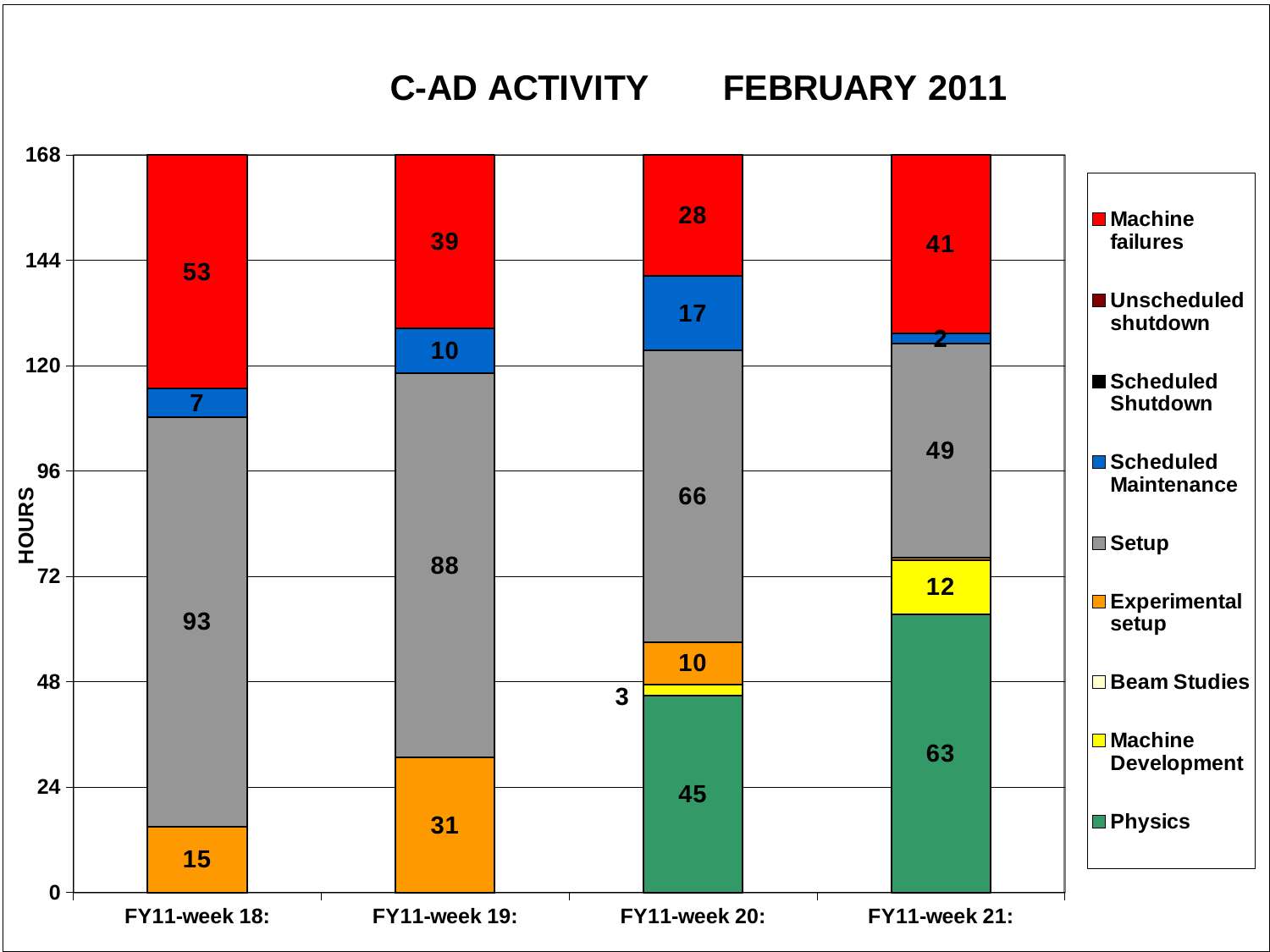
What is the Scheduled Maintenance value for FY11-week 20? 17 Which week has the lowest Setup value? FY11-week 21 What kind of chart is shown on the slide? Stacked bar chart How many series does the legend list? 9 How many weeks are shown on the x axis? 4 How many hours of Setup are shown for FY11-week 18? 93 What is the difference in Physics hours between FY11-week 21 and FY11-week 20? 18 Which week has the larger Experimental setup value, FY11-week 18 or FY11-week 19? FY11-week 19 How many Physics hours are shown for FY11-week 20? 45 What is the total of the stacked bar for FY11-week 18? 168 What is the Machine failures value for FY11-week 21? 41 Which week has the highest Machine failures value? FY11-week 18